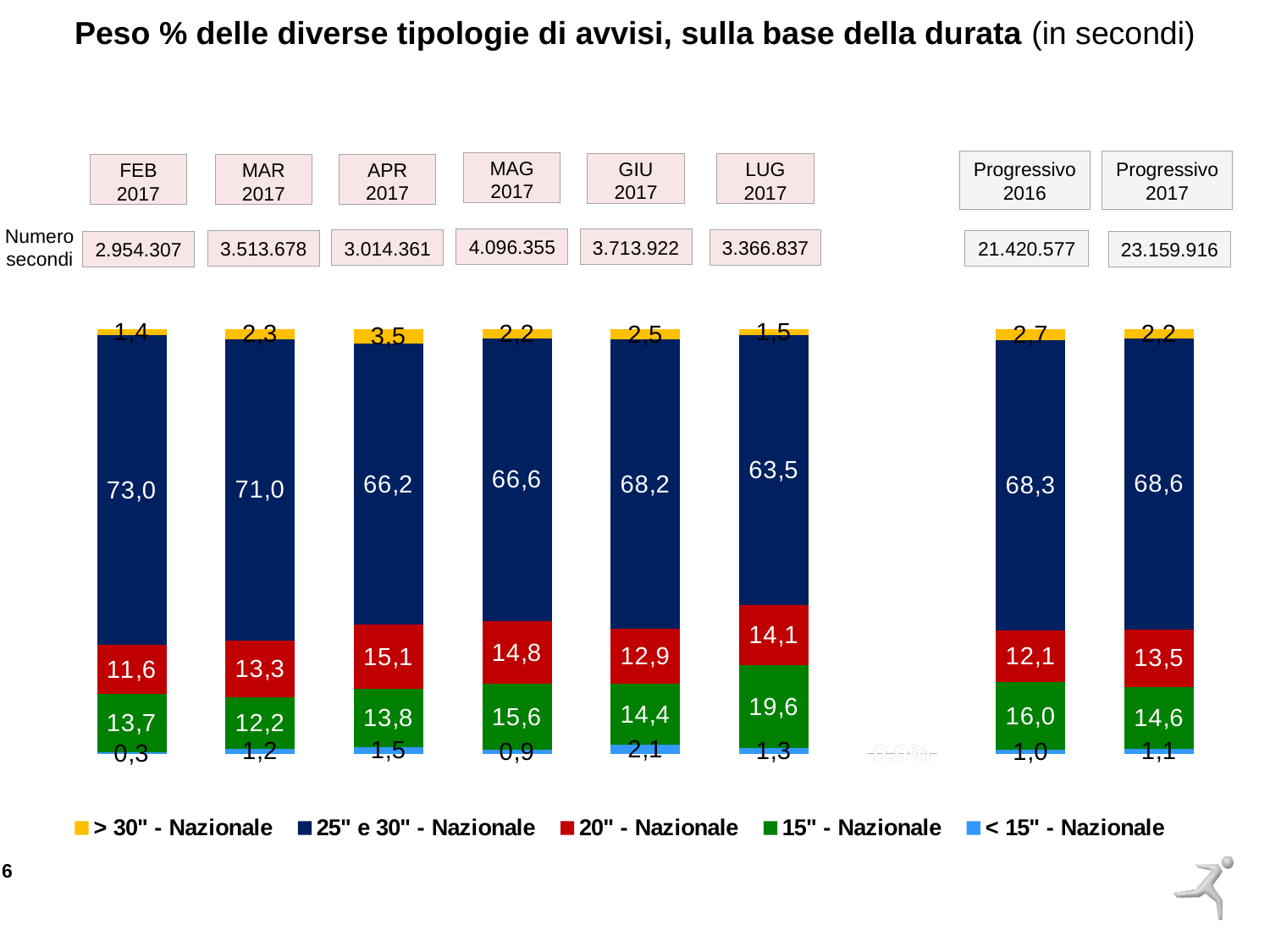
What kind of chart is shown on the slide? Stacked bar chart Which category has the highest value for the 25" e 30" - Nazionale series? FEB 2017 What is the value of the < 15" - Nazionale series for GIU 2017? 2,1 What is the value of the 25" e 30" - Nazionale series for FEB 2017? 73,0 How many series does the legend list? 5 What is the value of the > 30" - Nazionale series for APR 2017? 3,5 How many categories (bars) are shown in the chart? 8 Which has the larger 15" - Nazionale value, MAG 2017 or GIU 2017? MAG 2017 Which category has the lowest value for the 25" e 30" - Nazionale series? LUG 2017 What is the value of the 20" - Nazionale series for APR 2017? 15,1 What is the difference between the 20" - Nazionale values for Progressivo 2017 and Progressivo 2016? 1,4 What is the value of the 15" - Nazionale series for LUG 2017? 19,6